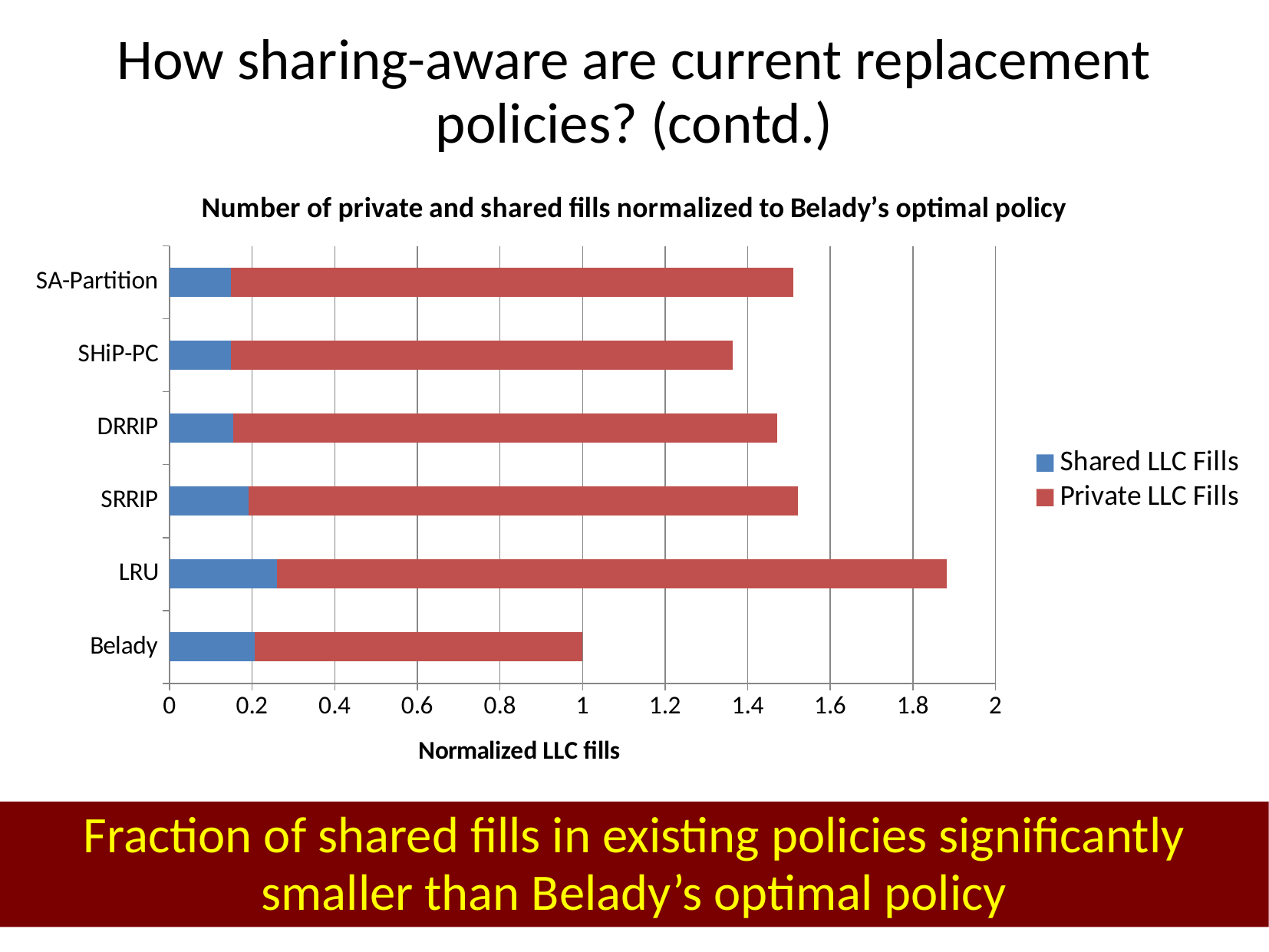
What is the total normalized LLC fills for Belady? 1 How many series does the chart legend list? 2 Which has a larger total normalized LLC fills, SA-Partition or SHiP-PC? SA-Partition Is the Shared LLC Fills value for LRU greater or less than 0.2? greater Is the total normalized LLC fills for SHiP-PC greater or less than 1.4? less Is the total normalized LLC fills for LRU greater or less than 1.8? greater Which policy has a larger Shared LLC Fills value, LRU or DRRIP? LRU What is the label of the horizontal axis of the chart? Normalized LLC fills How many replacement policies are listed on the vertical axis of the chart? 6 Which policy has the lowest total normalized LLC fills? Belady Which policy has the highest total normalized LLC fills? LRU What kind of chart is shown on the slide? Stacked bar chart